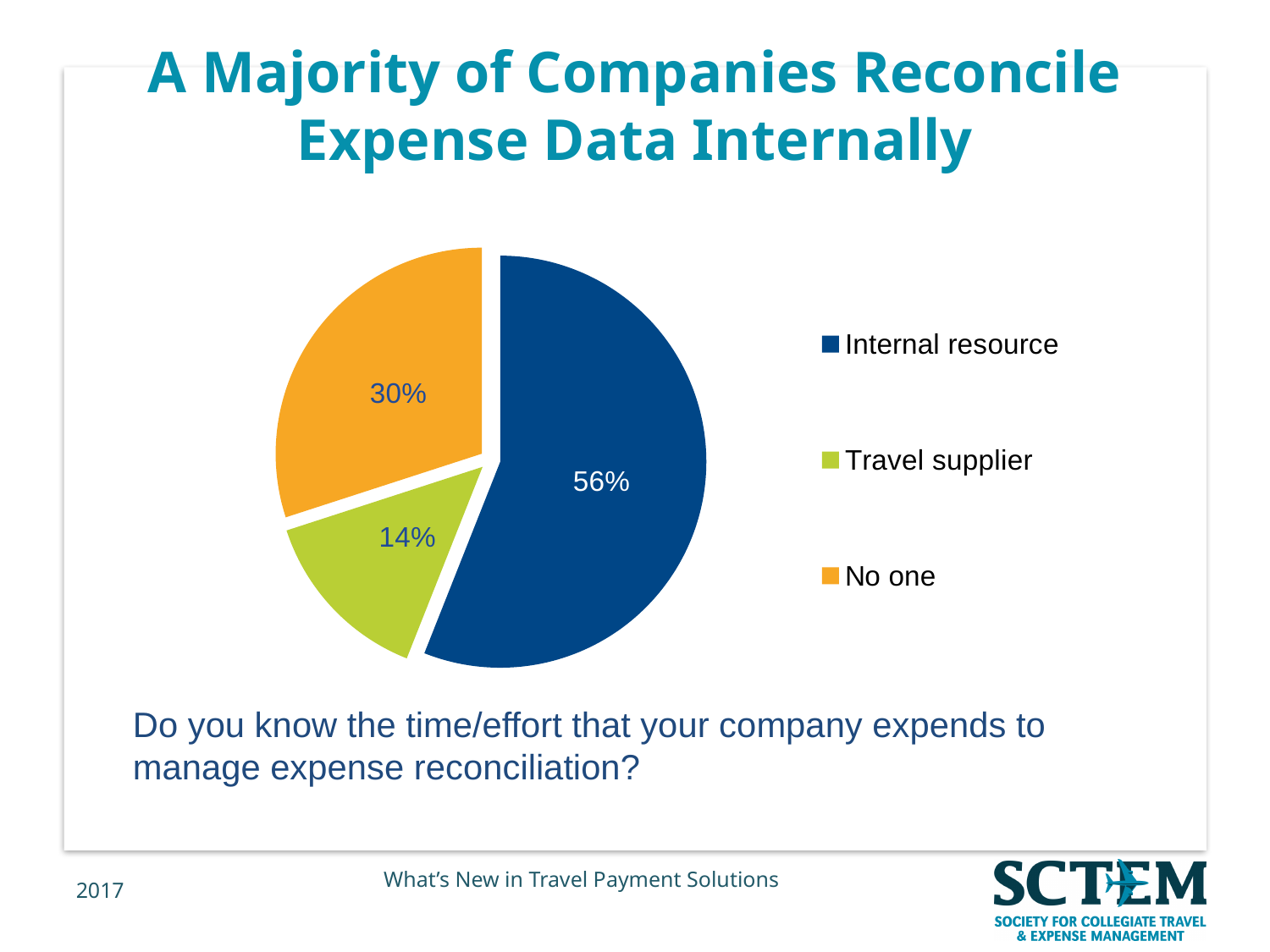
What share of the pie does Internal resource account for? 56% Which category has the largest slice of the pie? Internal resource What is the difference in percentage points between No one and Travel supplier? 16 How many categories does the pie chart show? 3 Which legend entry is listed first? Internal resource What colour is the slice for Travel supplier? Green What share of the pie does Travel supplier account for? 14% Which is larger, the share for No one or the share for Travel supplier? No one Which category has the smallest slice of the pie? Travel supplier What share of the pie does No one account for? 30% What kind of chart is shown on the slide? Pie chart What is the difference in percentage points between Internal resource and No one? 26